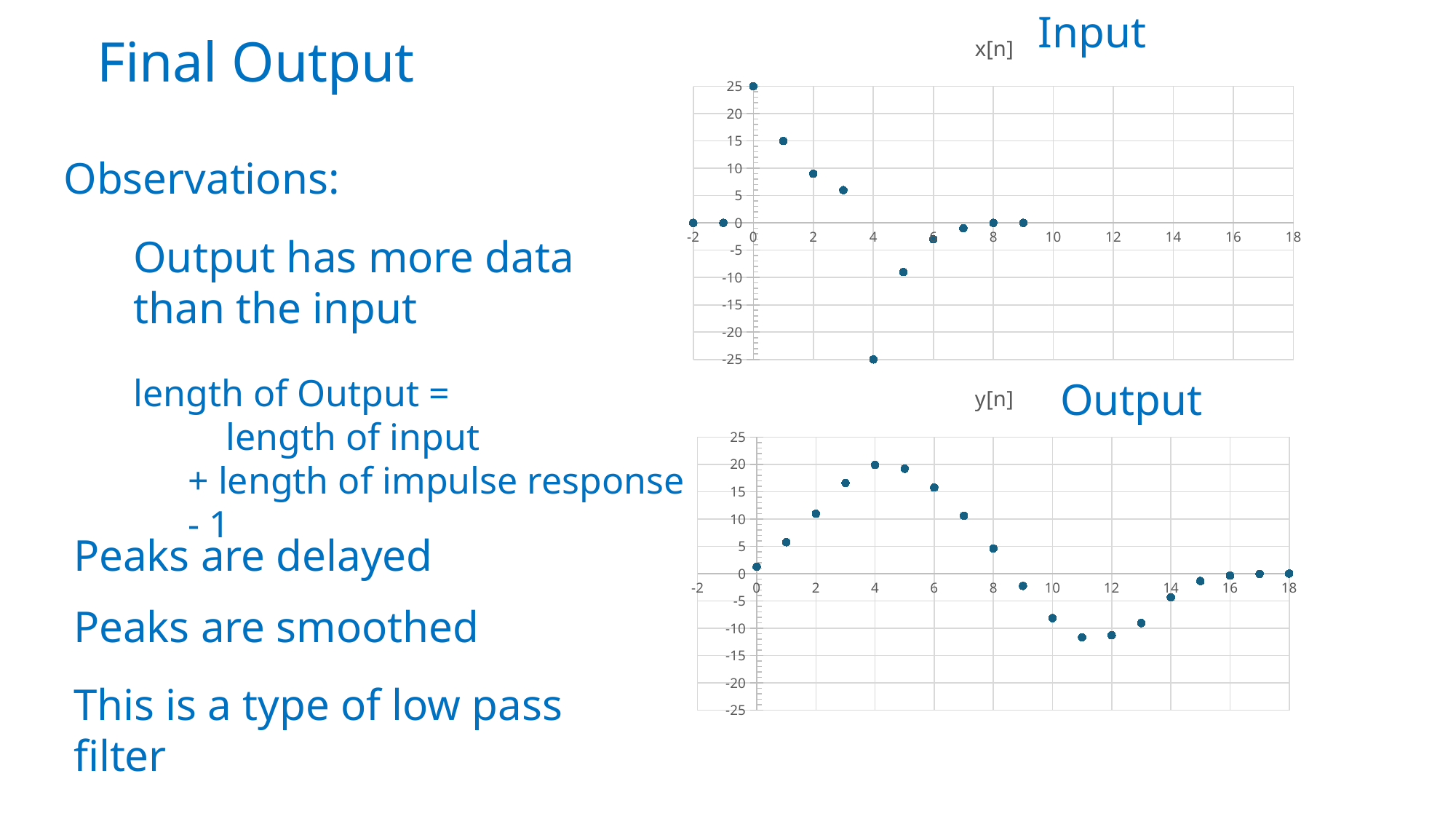
On the Input chart (x[n]), what is the value at n = 1? 15 What kind of chart is the Input chart (x[n])? scatter chart On the Input chart (x[n]), at which value of n is the lowest point? 4 On the Input chart (x[n]), at which value of n is the highest point? 0 What is the title of the bottom chart? y[n] On the Output chart (y[n]), which is larger, the value at n = 4 or the value at n = 8? n = 4 On the Input chart (x[n]), what is the value at n = 0? 25 On the Output chart (y[n]), at which value of n is the highest point? 4 On the Input chart (x[n]), what is the value at n = 4? -25 On the Output chart (y[n]), do the values rise or fall from n = 0 to n = 4? rise On the Output chart (y[n]), is the value at n = 10 greater or less than -5? less